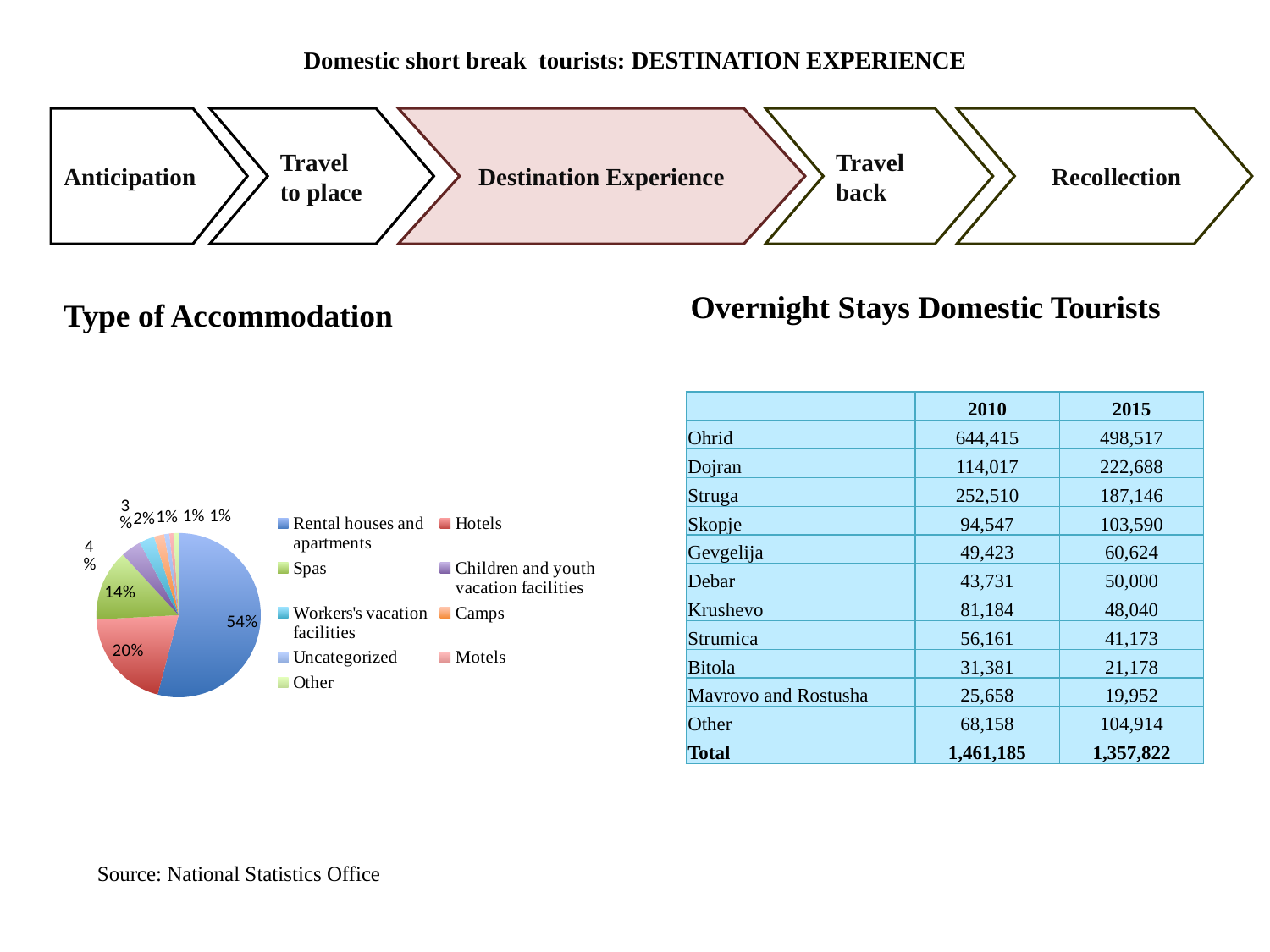
What type of chart is used for Type of Accommodation? pie chart In the Type of Accommodation pie chart, what share is Rental houses and apartments? 54% In the Type of Accommodation pie chart, what share is Children and youth vacation facilities? 4% In the Type of Accommodation pie chart, what colour is the Hotels slice? red In the Type of Accommodation pie chart, which accommodation type has the largest share? Rental houses and apartments In the Type of Accommodation pie chart, what share is Hotels? 20% In the Overnight Stays Domestic Tourists table, how many overnight stays did Ohrid have in 2015? 498,517 In the Type of Accommodation pie chart, what share is Spas? 14% How many accommodation types does the legend of the Type of Accommodation pie chart list? 9 In the Type of Accommodation pie chart, what is the difference in percentage points between Rental houses and apartments and Hotels? 34 In the Type of Accommodation pie chart, which is larger, Hotels or Spas? Hotels In the Overnight Stays Domestic Tourists table, what is the total for 2010? 1,461,185